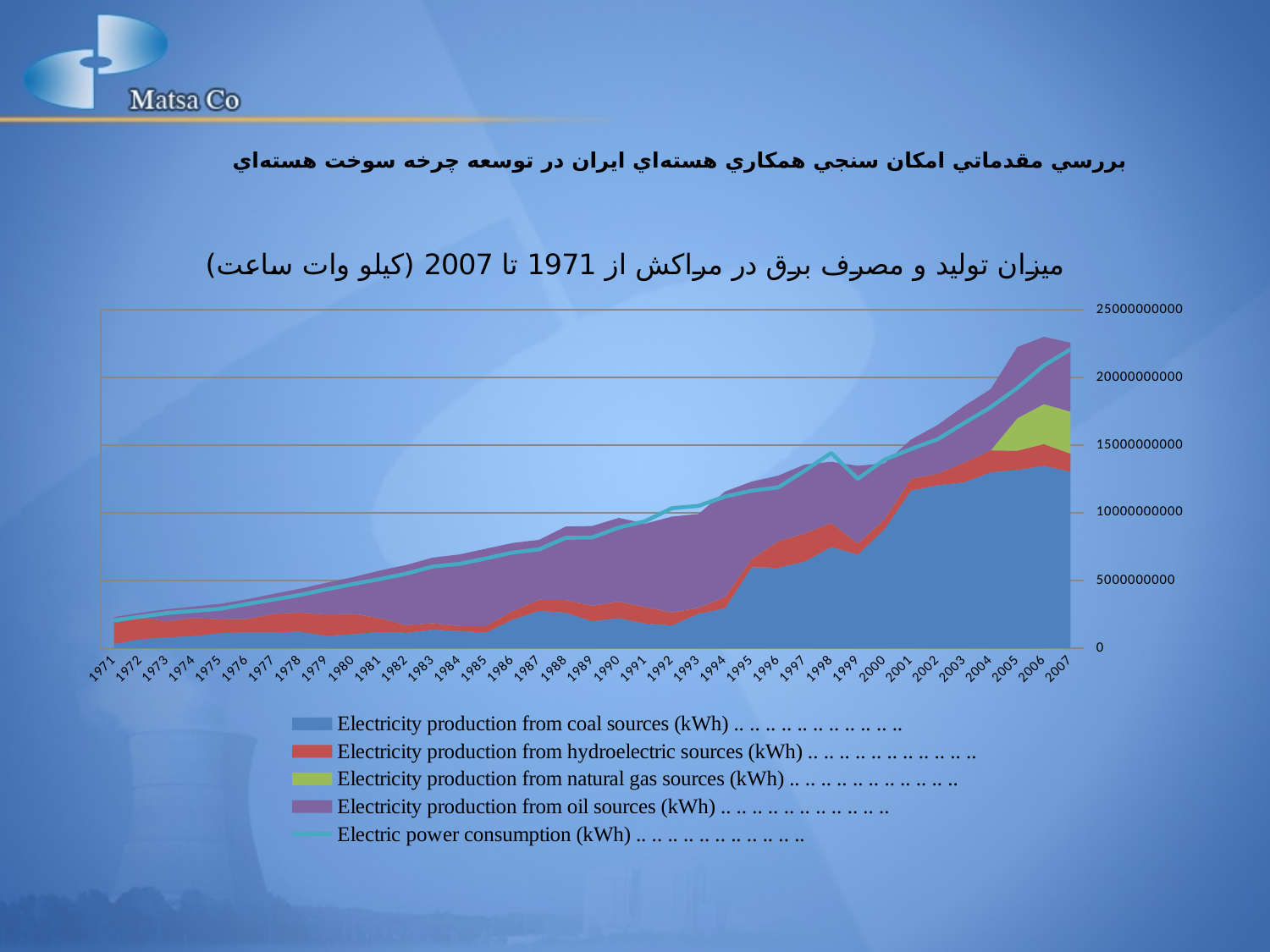
Which series is drawn as a line rather than a filled area? Electric power consumption (kWh) Is the electric power consumption value for 1975 greater or less than 5000000000? less How many series does the legend list? 5 Is electric power consumption larger in 2007 or in 1971? 2007 What is the first year shown on the x axis? 1971 Is the electric power consumption value for 2007 greater or less than 20000000000? greater Is the electric power consumption value for 2003 greater or less than 15000000000? greater What kind of chart is shown on the slide? area and line chart In which year is electric power consumption highest? 2007 In which year is electric power consumption lowest? 1971 How many years are shown along the x axis? 37 Does electric power consumption generally rise or fall from 1971 to 2007? rise